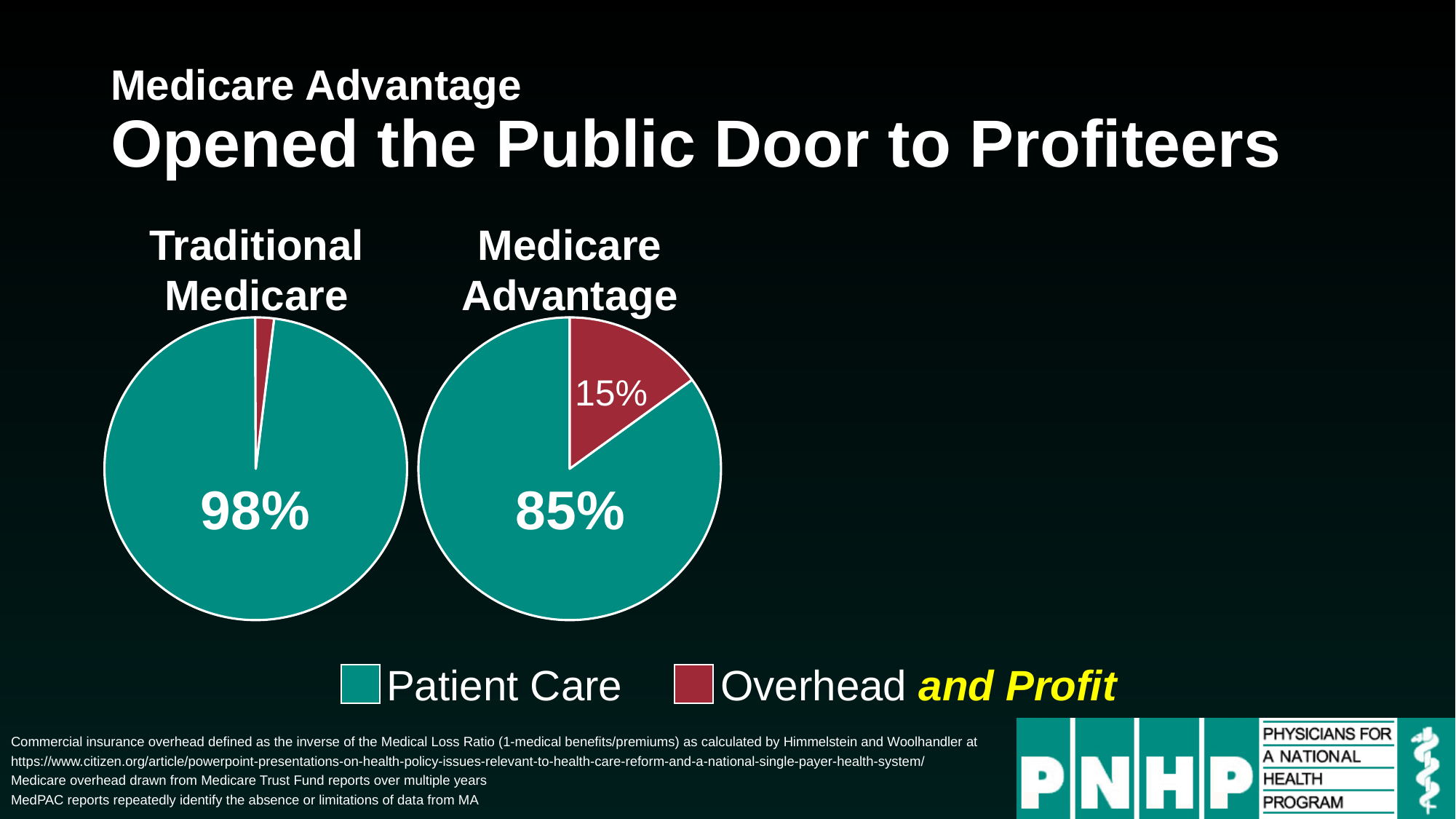
How many categories does the legend list? 2 In the Medicare Advantage pie chart, which slice is the smallest? Overhead and Profit What kind of charts are shown on the slide? Pie charts How many pie charts are on the slide? 2 What is the difference in the labelled Patient Care share between the Traditional Medicare and Medicare Advantage pie charts? 13 percentage points Which pie chart shows the larger Patient Care share, Traditional Medicare or Medicare Advantage? Traditional Medicare Which pie chart has the larger Overhead and Profit slice, Traditional Medicare or Medicare Advantage? Medicare Advantage In the Traditional Medicare pie chart, what share is labelled for Patient Care? 98% What colour represents Overhead and Profit in the legend? Red In the Medicare Advantage pie chart, what share is labelled for Patient Care? 85% In the Medicare Advantage pie chart, which slice is the largest? Patient Care In the Medicare Advantage pie chart, what share is labelled for Overhead and Profit? 15%